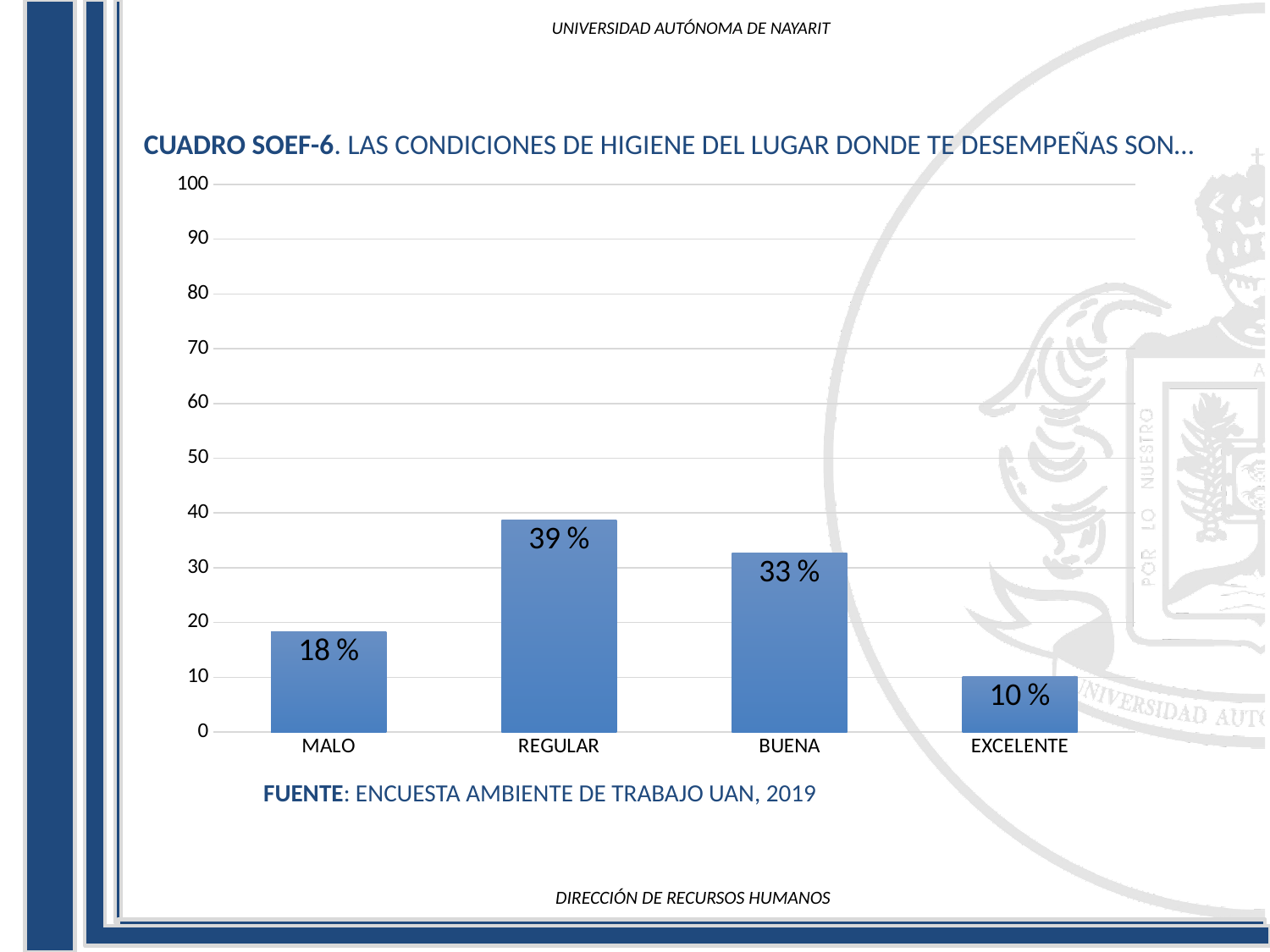
Which category has the lowest value? EXCELENTE What kind of chart is shown on the slide? bar chart How many categories are shown on the x axis? 4 Which category has the highest value? REGULAR Is the value for BUENA greater or less than 40? less What is the value for BUENA? 33 % What is the value for MALO? 18 % What is the value for EXCELENTE? 10 % Which is larger, the value for MALO or the value for EXCELENTE? MALO What is the value for REGULAR? 39 % What source is cited below the chart? ENCUESTA AMBIENTE DE TRABAJO UAN, 2019 What is the difference between the values for REGULAR and BUENA? 6 %